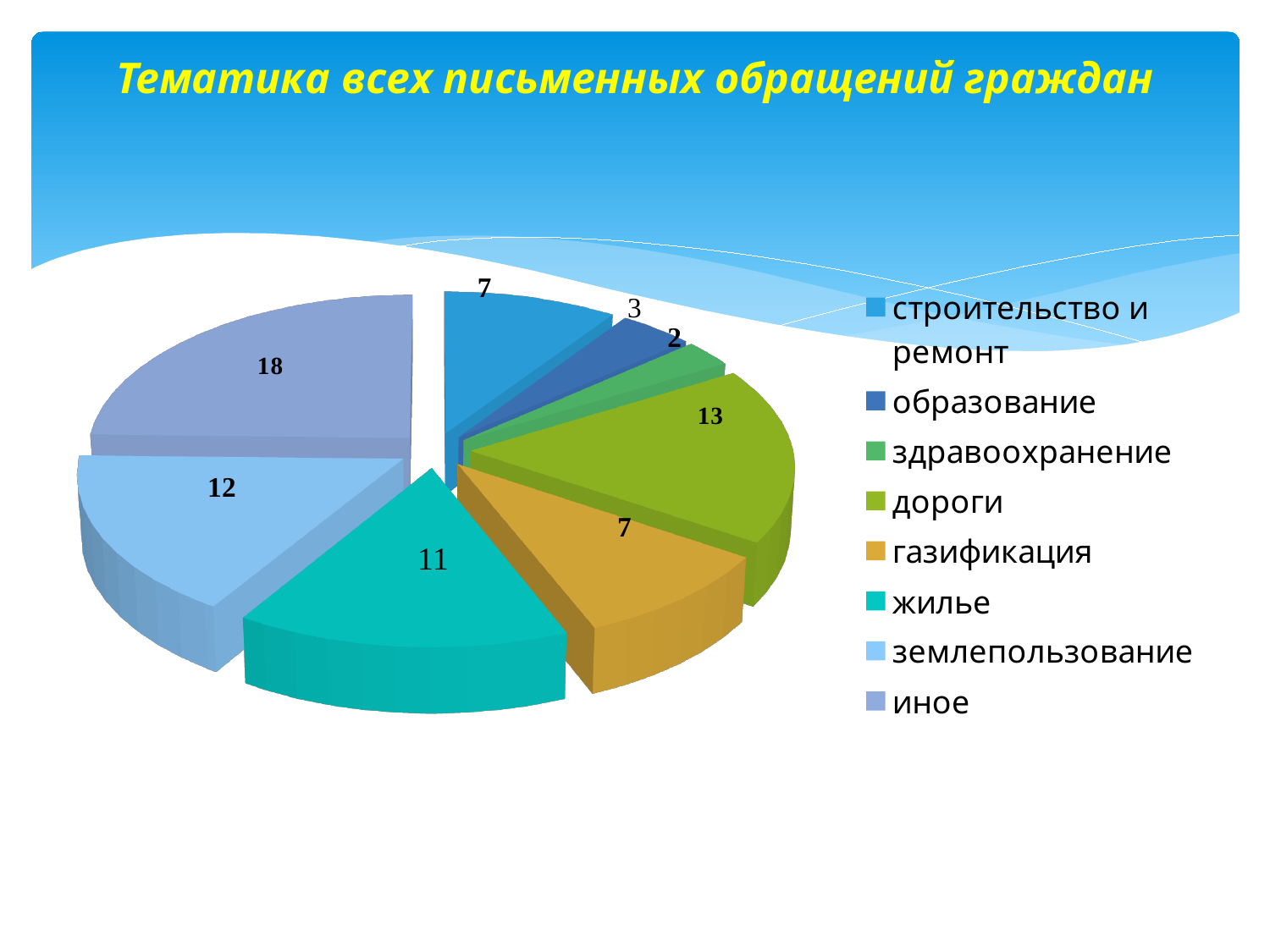
What is the value for иное? 18 Which category has the largest value? иное Which category has the smallest value? здравоохранение What is the value for здравоохранение? 2 What is the difference between the values for иное and землепользование? 6 What is the value for жилье? 11 How many categories does the legend list? 8 What kind of chart is shown on the slide? pie chart What is the value for дороги? 13 What is the total of all the slices in the pie? 73 Which is larger, the value for дороги or the value for жилье? дороги What is the title of the chart? Тематика всех письменных обращений граждан